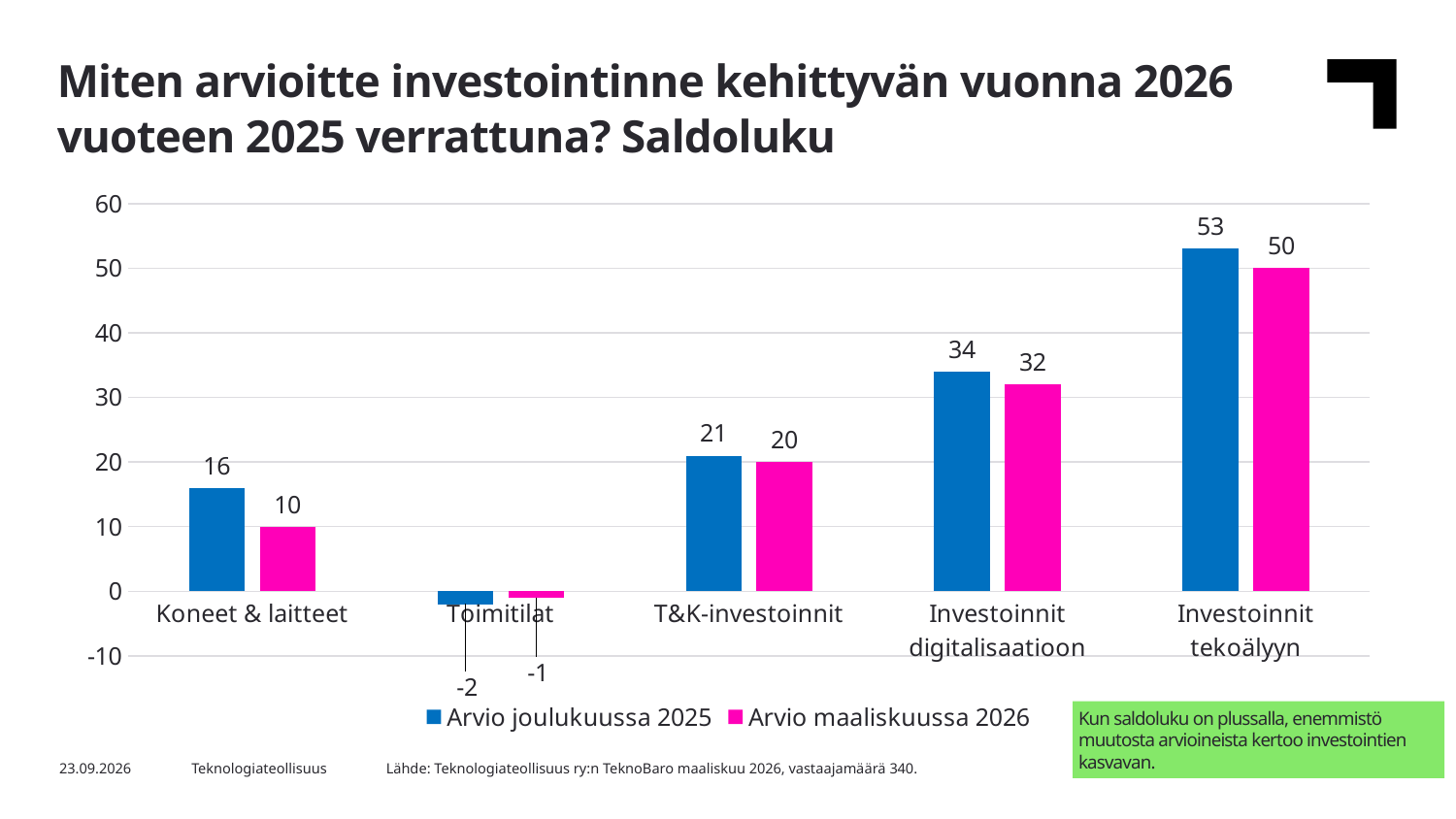
What is the difference between the Arvio joulukuussa 2025 and Arvio maaliskuussa 2026 values for Koneet & laitteet? 6 Which category has the lowest value in the Arvio maaliskuussa 2026 series? Toimitilat What is the value for Toimitilat in the Arvio joulukuussa 2025 series? -2 What colour are the bars for the Arvio maaliskuussa 2026 series? magenta (pink) What kind of chart is shown on the slide? bar chart What is the value for Koneet & laitteet in the Arvio joulukuussa 2025 series? 16 Is the Arvio maaliskuussa 2026 value for T&K-investoinnit greater or less than 30? less What is the value for Investoinnit tekoälyyn in the Arvio maaliskuussa 2026 series? 50 Which is larger for Investoinnit digitalisaatioon: the Arvio joulukuussa 2025 value or the Arvio maaliskuussa 2026 value? Arvio joulukuussa 2025 How many categories are shown on the x axis? 5 Which category has the highest value in the Arvio joulukuussa 2025 series? Investoinnit tekoälyyn How many series does the legend list? 2